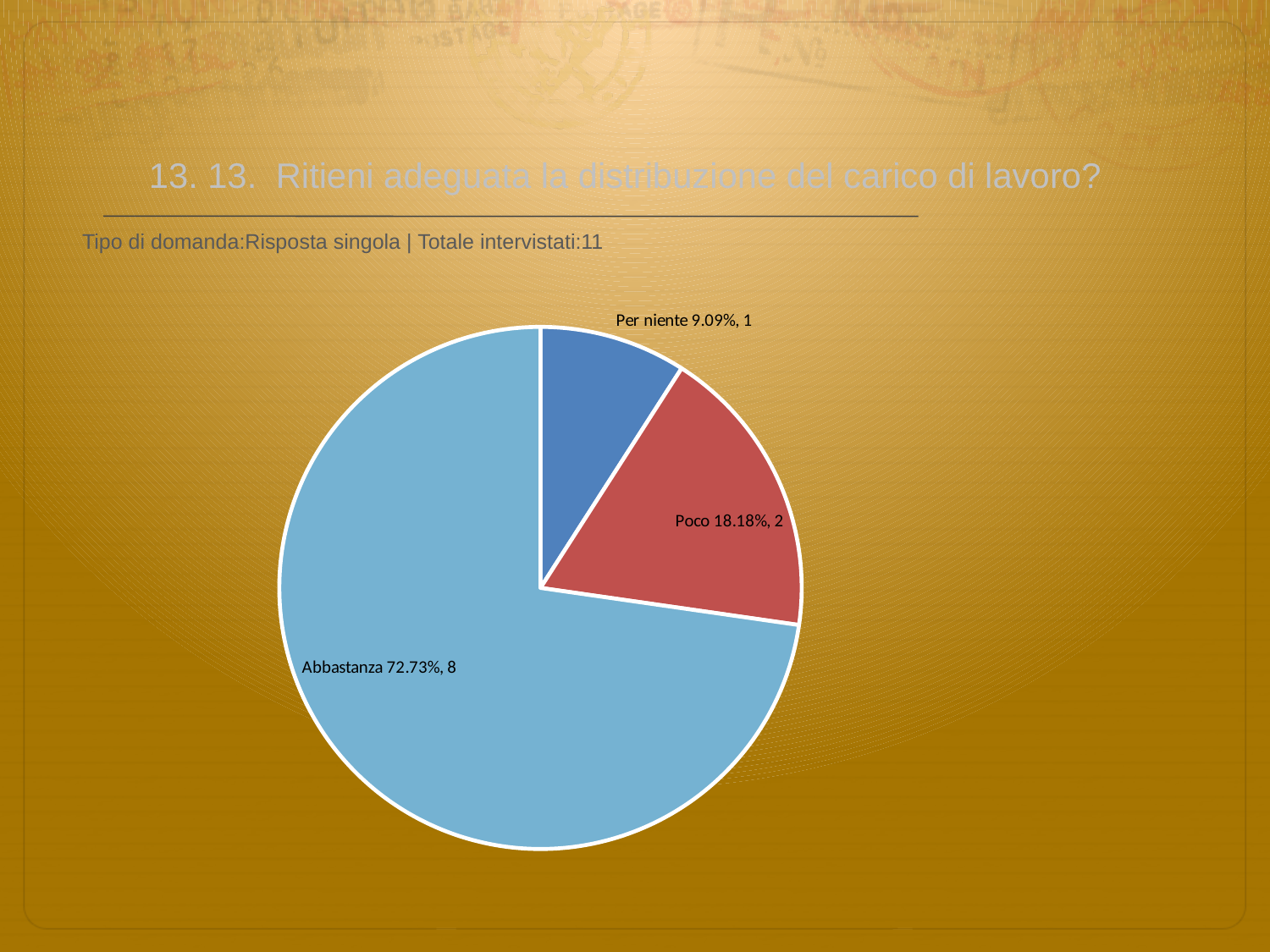
What percentage share does the 'Abbastanza' slice have? 72.73% Which category has the largest slice? Abbastanza Which category has the smallest slice? Per niente How many respondents chose 'Poco'? 2 How many respondents chose 'Abbastanza'? 8 What percentage share does the 'Poco' slice have? 18.18% What kind of chart is shown on the slide? pie chart Which slice is larger, 'Poco' or 'Per niente'? Poco How many respondents chose 'Per niente'? 1 How many slices does the pie chart have? 3 What percentage share does the 'Per niente' slice have? 9.09% What is the difference in respondent count between 'Abbastanza' and 'Poco'? 6